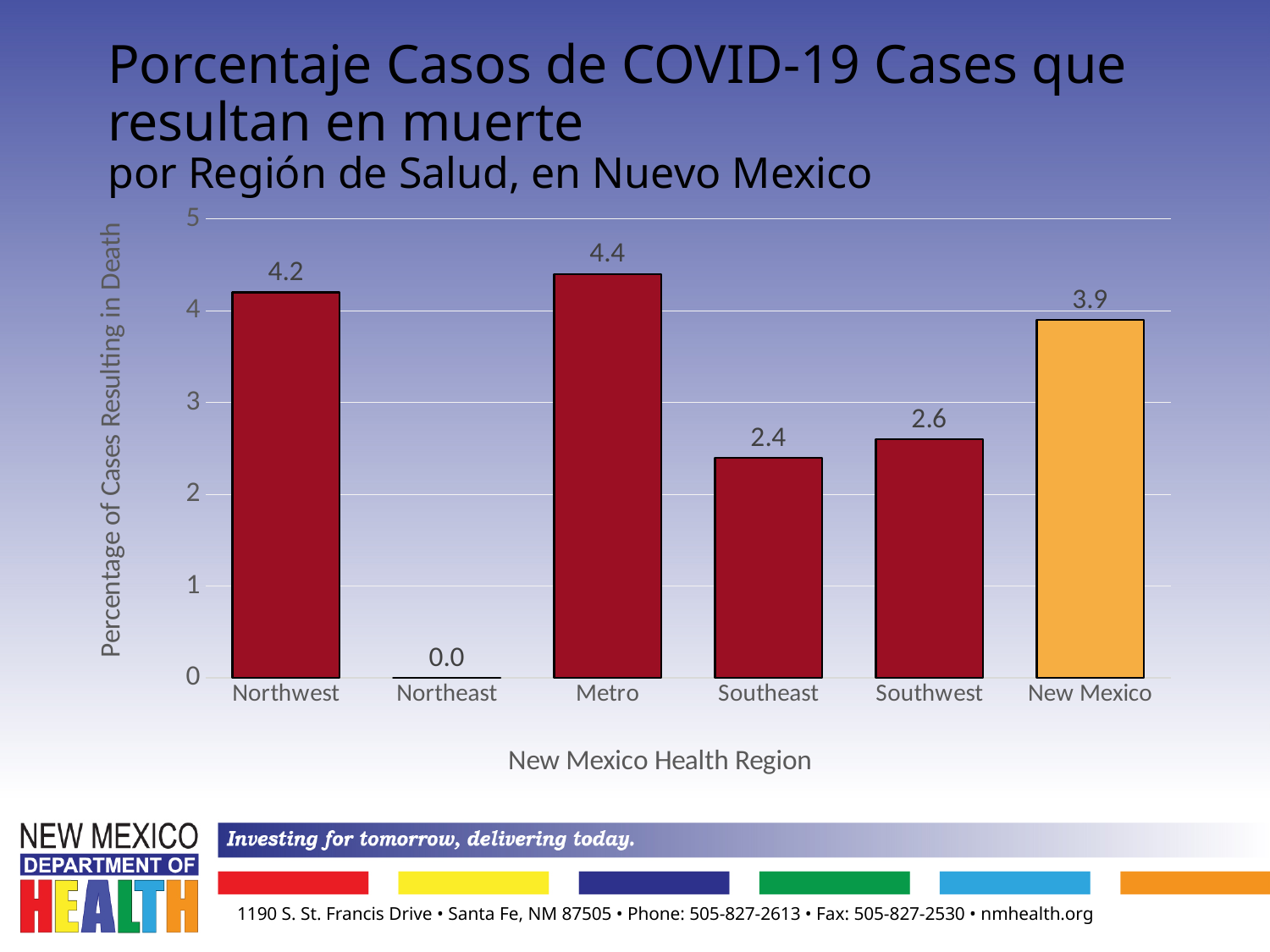
What is the value shown for New Mexico overall? 3.9 What is the difference between the values for Southwest and Southeast? 0.2 Which region has the lowest percentage of cases resulting in death? Northeast How many categories are shown on the x axis? 6 Is the value for Southeast greater or less than 3? less What is the percentage of cases resulting in death for the Northwest region? 4.2 What is the value shown for the Northeast region? 0.0 What is the value shown for the Metro region? 4.4 What is the difference between the values for Metro and New Mexico? 0.5 Which is larger, the value for Northwest or the value for Southwest? Northwest What type of chart is shown on the slide? bar chart Which region has the highest percentage of cases resulting in death? Metro